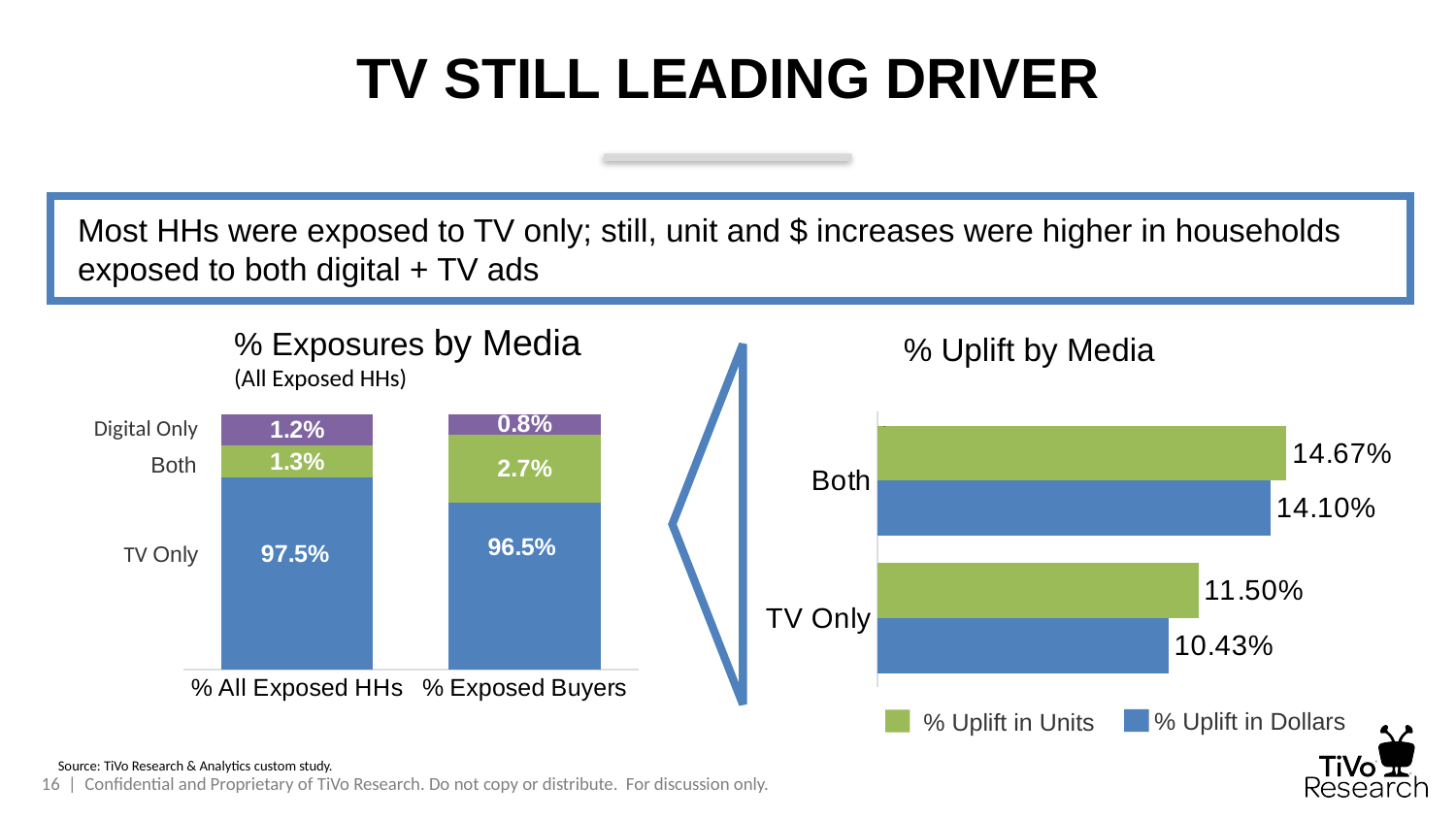
In the '% Uplift by Media' chart, what is the difference between % Uplift in Units and % Uplift in Dollars for TV Only? 1.07% In the '% Exposures by Media' chart, which is larger: the Both share for % All Exposed HHs or for % Exposed Buyers? % Exposed Buyers In the '% Exposures by Media' chart, what is the Both share for % All Exposed HHs? 1.3% In the '% Uplift by Media' chart, what is the % Uplift in Dollars for TV Only? 10.43% In the '% Uplift by Media' chart, what is the % Uplift in Units for Both? 14.67% In the '% Uplift by Media' chart, which category has the highest % Uplift in Dollars? Both What kind of chart is the '% Exposures by Media' chart? Stacked bar chart How many series does the legend of the '% Uplift by Media' chart list? 2 How many categories are shown on the '% Uplift by Media' chart? 2 In the '% Exposures by Media' chart, which segment is smallest in the % Exposed Buyers bar? Digital Only In the '% Uplift by Media' chart, which colour represents % Uplift in Units? Green In the '% Exposures by Media' chart, what is the TV Only share for % Exposed Buyers? 96.5%